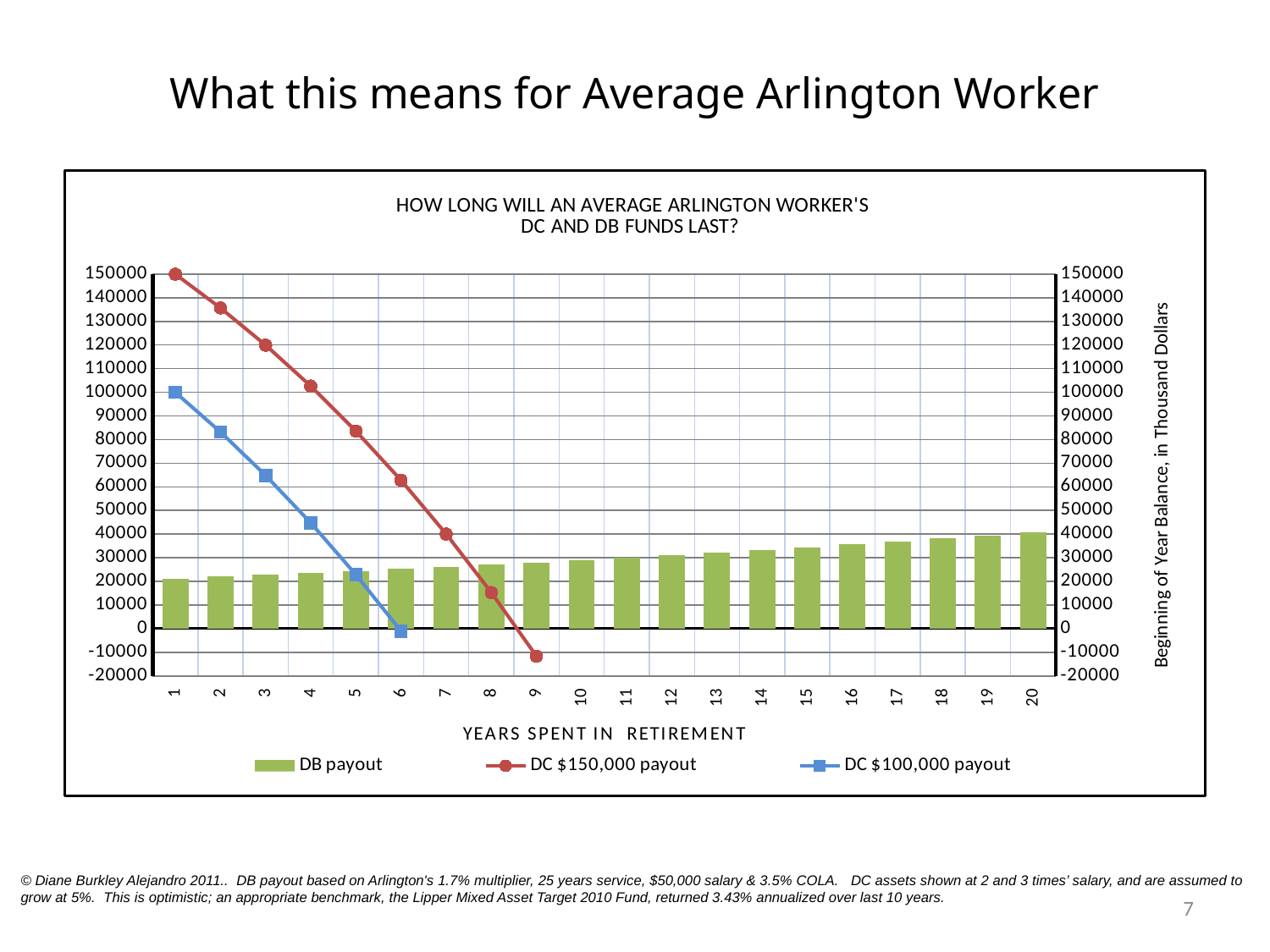
Is the DC $100,000 payout value at year 4 greater or less than 50000? less Is the DC $150,000 payout value at year 5 greater or less than 70000? greater Is the DB payout value at year 1 greater or less than 30000? less What is the title of the chart? HOW LONG WILL AN AVERAGE ARLINGTON WORKER'S DC AND DB FUNDS LAST? What is the value of the DC $150,000 payout series at year 1? 150000 At year 3, which is larger: the DC $150,000 payout or the DC $100,000 payout? DC $150,000 payout Does the DB payout rise or fall as the years spent in retirement increase? rise How many series does the legend list? 3 What kind of chart is shown on the slide? A combination bar and line chart How many years spent in retirement are shown on the x axis? 20 What is the value of the DC $100,000 payout series at year 1? 100000